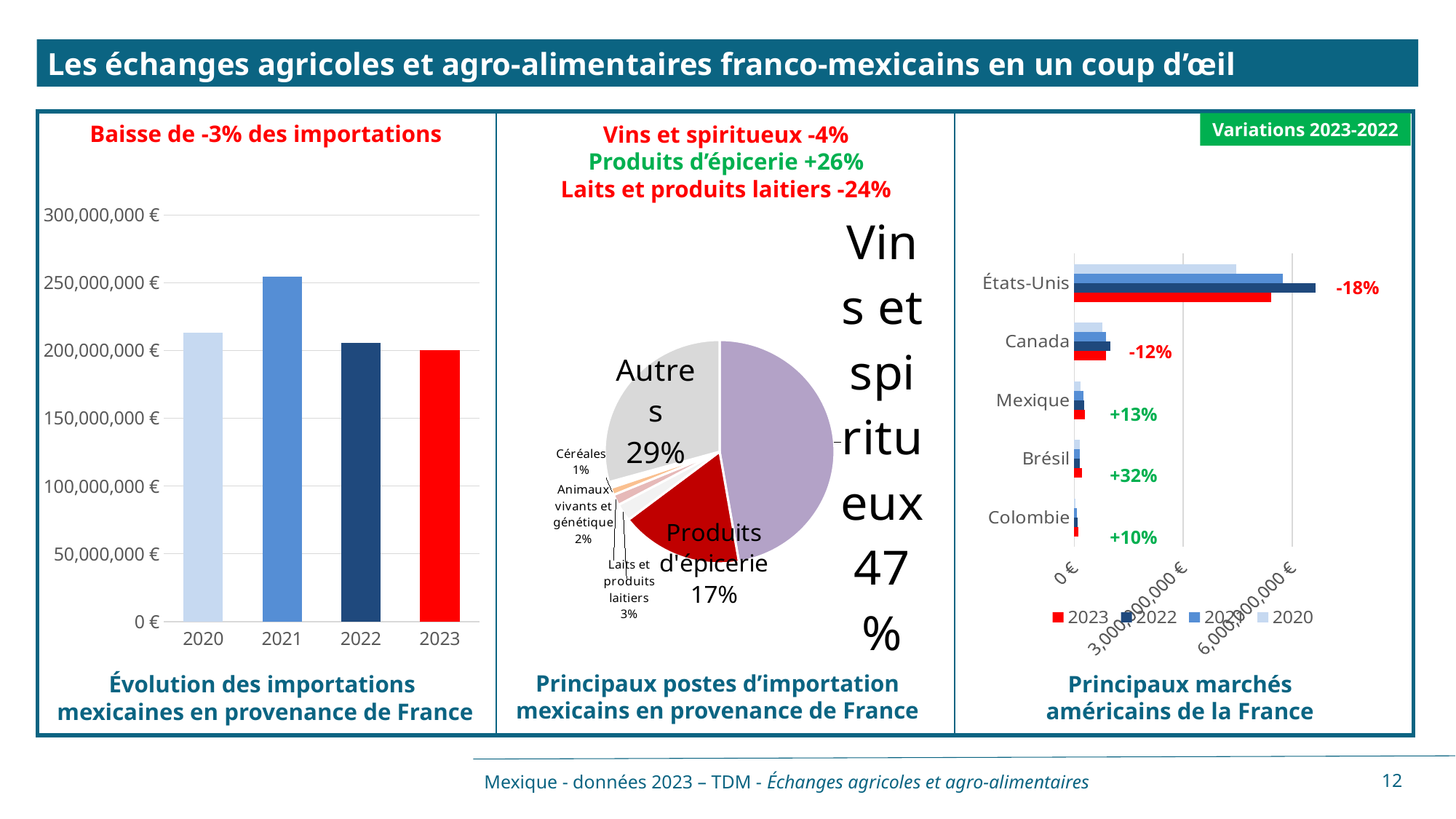
In the pie chart 'Principaux postes d'importation mexicains en provenance de France', which category has the smallest share? Céréales In the pie chart 'Principaux postes d'importation mexicains en provenance de France', what share does 'Vins et spiritueux' have? 47% In the chart 'Principaux marchés américains de la France', which country has the highest values? États-Unis What kind of chart is 'Évolution des importations mexicaines en provenance de France'? bar chart What kind of chart is 'Principaux postes d'importation mexicains en provenance de France'? pie chart In the chart 'Évolution des importations mexicaines en provenance de France', which year has the highest value? 2021 How many years are shown in the chart 'Évolution des importations mexicaines en provenance de France'? 4 In the chart 'Principaux marchés américains de la France', what is the 2023-2022 variation shown for Brésil? +32% In the pie chart 'Principaux postes d'importation mexicains en provenance de France', what is the difference in percentage points between 'Vins et spiritueux' and 'Produits d'épicerie'? 30 In the chart 'Évolution des importations mexicaines en provenance de France', is the value for 2020 greater or less than 200,000,000 €? greater How many series does the legend of the chart 'Principaux marchés américains de la France' list? 4